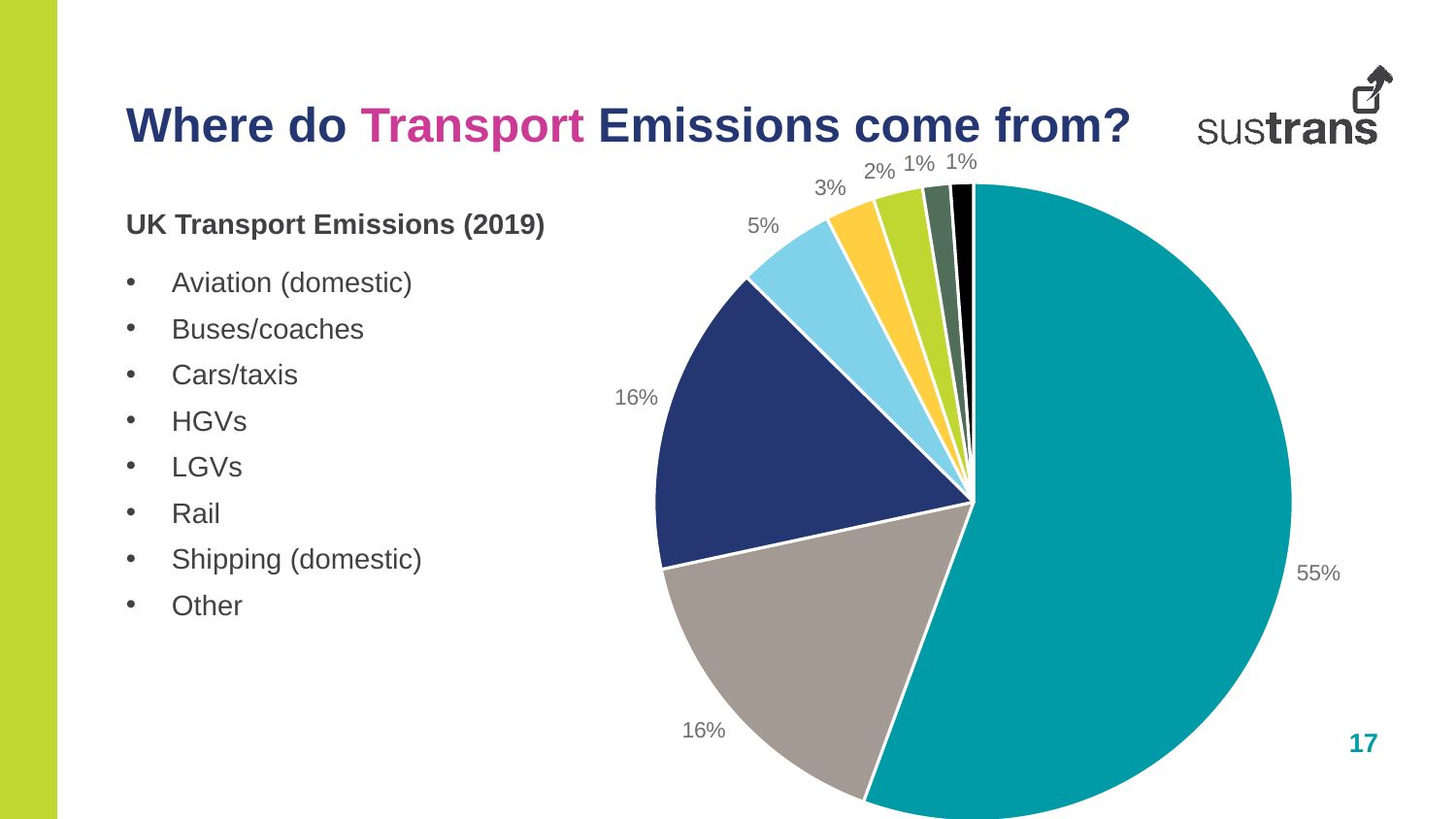
What is the combined share of the five smallest slices (5%, 3%, 2%, 1%, 1%)? 12% What colour is the largest slice of the pie chart? Teal What is the difference in percentage points between the largest slice (55%) and one of the 16% slices? 39 percentage points What is the combined share of the two slices labelled 16%? 32% Does the largest slice of the pie chart account for more or less than half of the total? More What is the value of the smallest slices in the pie chart? 1% What is the value of the largest slice in the pie chart? 55% Which is larger, the slice labelled 5% or the slice labelled 3%? The 5% slice What kind of chart is shown on the slide? Pie chart How many slices in the pie chart are labelled 16%? 2 What is the title of the slide containing the pie chart? Where do Transport Emissions come from? How many slices does the pie chart have? 8